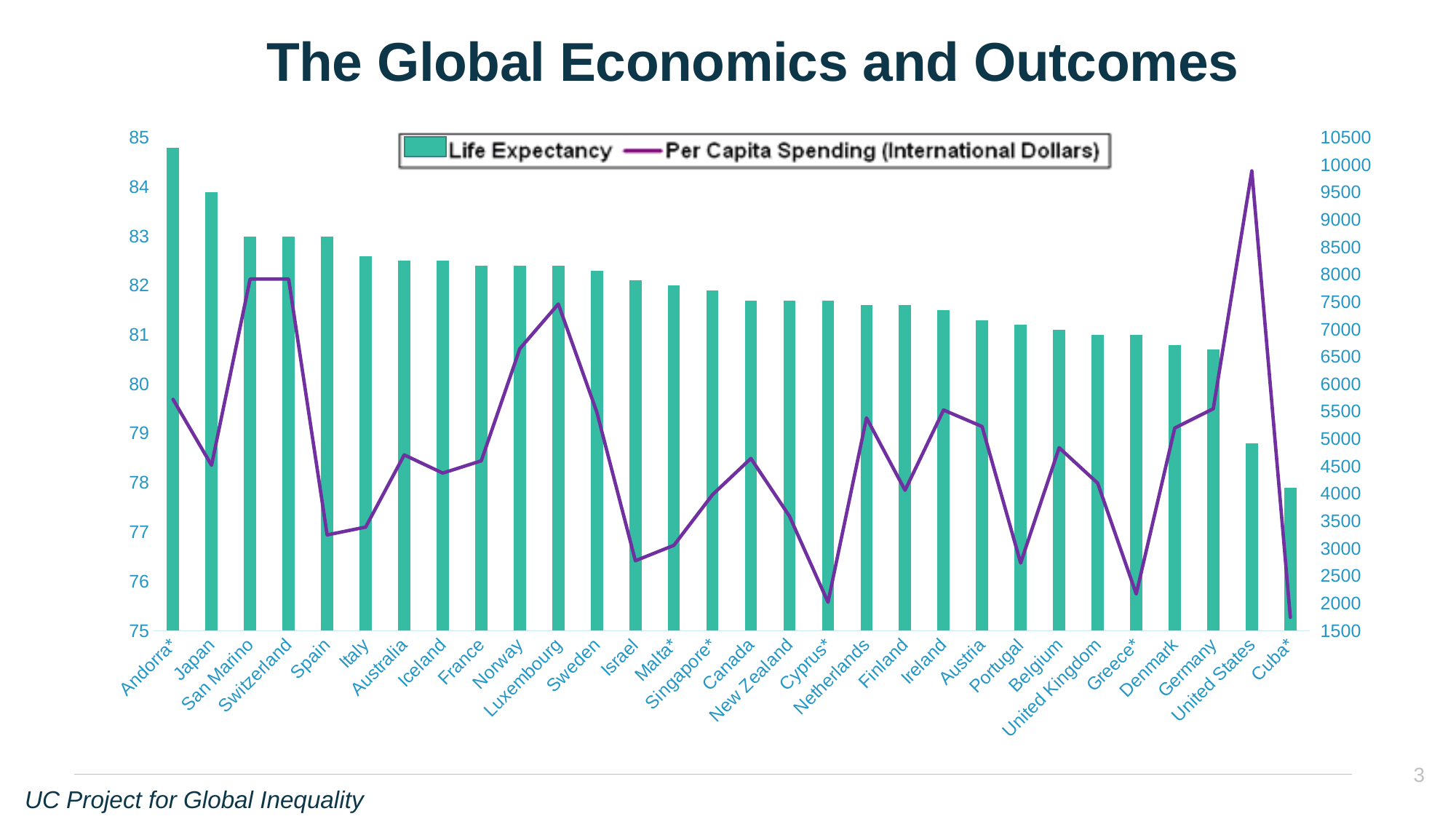
How many series does the legend list? 2 How many countries are shown on the x axis? 30 Which has the higher per capita spending, the United States or Switzerland? United States Which country has the highest life expectancy? Andorra* Is the per capita spending for Cyprus* greater or less than 2500? less Is the per capita spending for the United States greater or less than 9500? greater Which has the higher life expectancy, Japan or Italy? Japan Which country has the lowest life expectancy? Cuba* Which country has the highest per capita spending? United States Do the life expectancy bars generally rise or fall from left to right along the x axis? fall What kind of chart is shown on the slide? A bar chart combined with a line chart